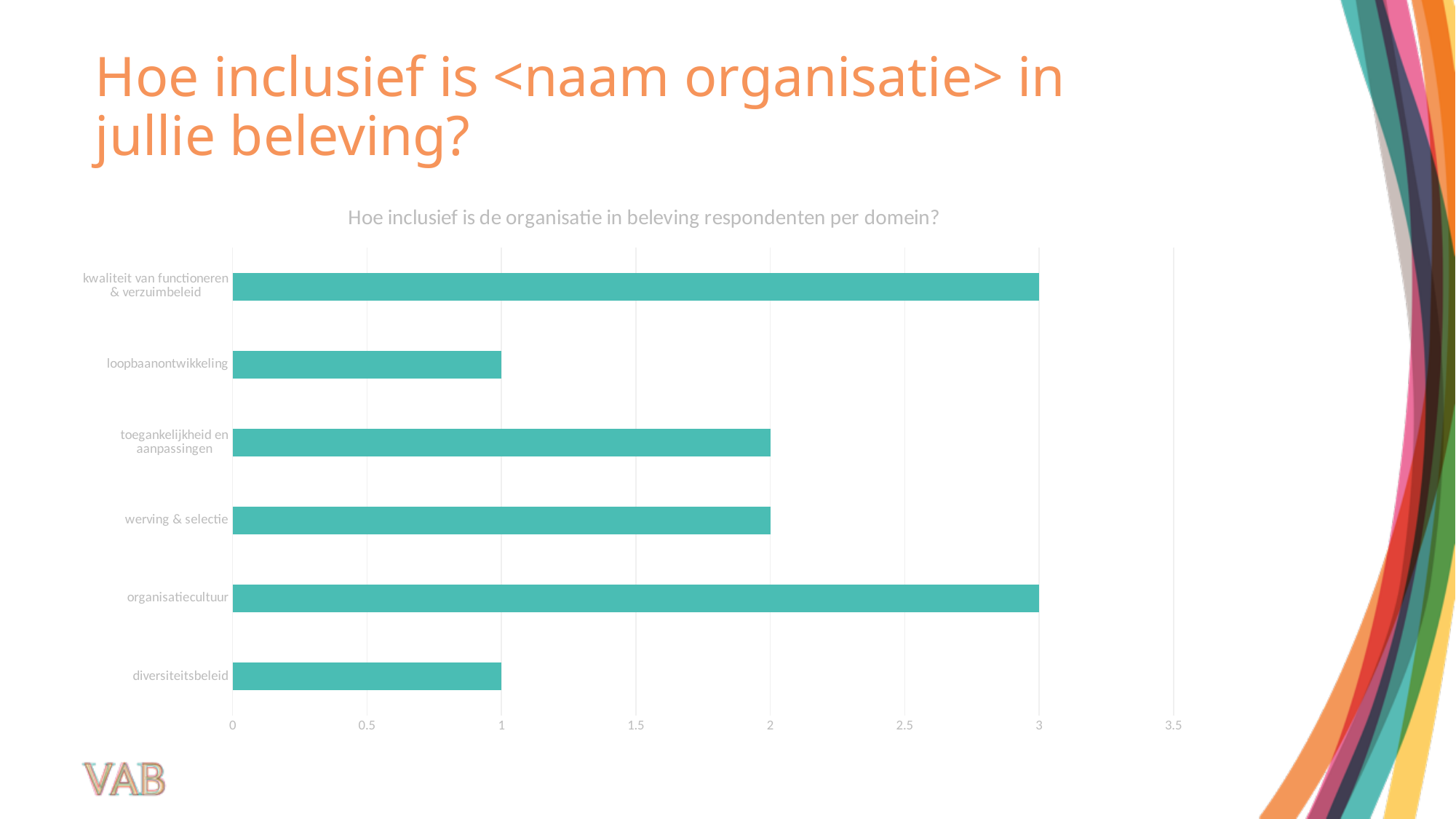
What is the value for loopbaanontwikkeling? 1 Which is larger, the value for organisatiecultuur or the value for diversiteitsbeleid? organisatiecultuur What is the highest value shown on the x axis? 3.5 What is the value for kwaliteit van functioneren & verzuimbeleid? 3 What kind of chart is shown on the slide? bar chart What is the value for diversiteitsbeleid? 1 What is the difference between the value for kwaliteit van functioneren & verzuimbeleid and the value for loopbaanontwikkeling? 2 What is the value for organisatiecultuur? 3 What is the value for werving & selectie? 2 What is the title of the chart? Hoe inclusief is de organisatie in beleving respondenten per domein? How many categories are plotted in the chart? 6 Is the value for toegankelijkheid en aanpassingen greater or less than 1.5? greater